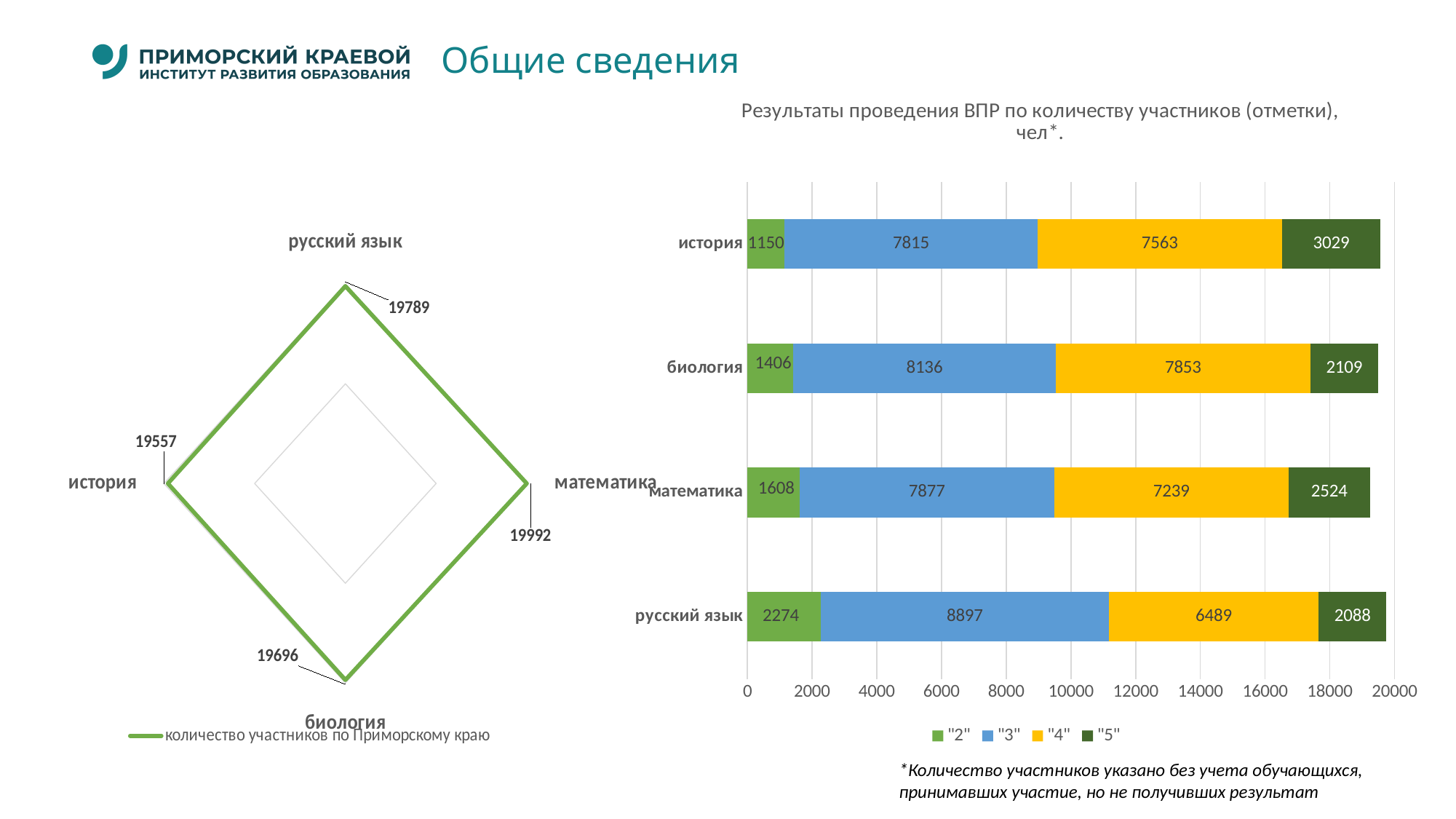
In the stacked bar chart on the right, how many participants received a "3" in биология? 8136 In the stacked bar chart on the right, which subject has the largest number of "2" grades? русский язык In the radar chart on the left, what is the difference between the participants for математика and история? 435 In the stacked bar chart on the right, which is larger: the number of "4" grades in биология or in русский язык? биология In the radar chart on the left, what is the number of participants for математика? 19992 In the radar chart on the left, how many subjects are plotted? 4 What type of chart is shown on the right side of the slide? stacked bar chart In the stacked bar chart on the right, how many series does the legend list? 4 In the radar chart on the left, which subject has the lowest number of participants? история In the radar chart on the left, which subject has the highest number of participants? математика In the stacked bar chart on the right, what is the total number of participants for история? 19557 In the stacked bar chart on the right, how many participants received a "5" in история? 3029